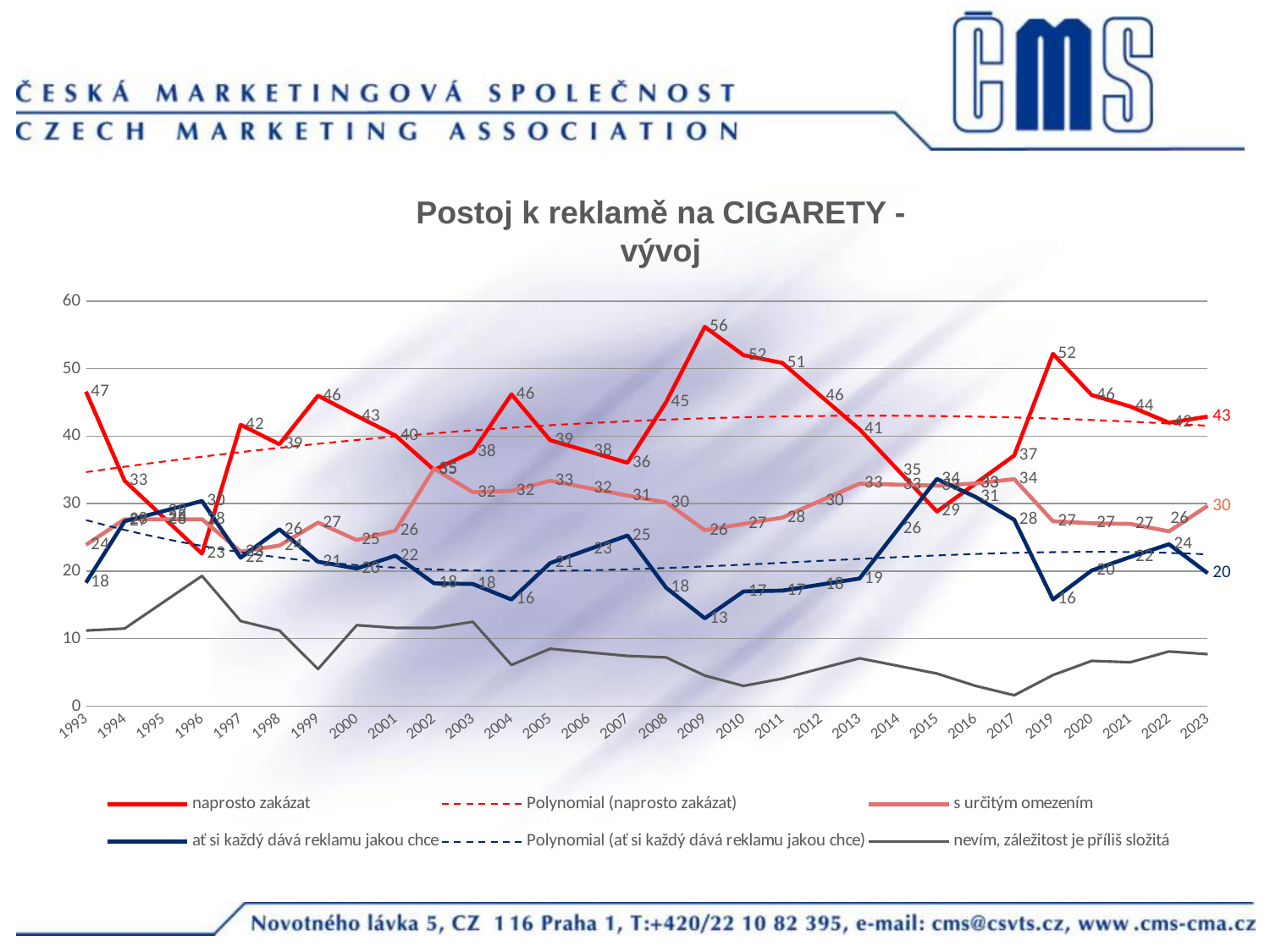
How many series does the legend list? 6 What is the value for 'naprosto zakázat' in 2009? 56 In which year does the 'naprosto zakázat' series reach its highest value? 2009 What is the difference between the 'naprosto zakázat' values in 2009 and 2023? 13 In which year is the 'ať si každý dává reklamu jakou chce' series at its lowest? 2009 What is the value for 'ať si každý dává reklamu jakou chce' in 2023? 20 Is the value for 'nevím, záležitost je příliš složitá' in 2017 greater or less than 10? less How many years are shown on the x axis? 30 What is the title of the chart? Postoj k reklamě na CIGARETY - vývoj In 2019, which is larger: 'naprosto zakázat' or 's určitým omezením'? naprosto zakázat What kind of chart is shown on the slide? line chart What is the value for 's určitým omezením' in 2023? 30